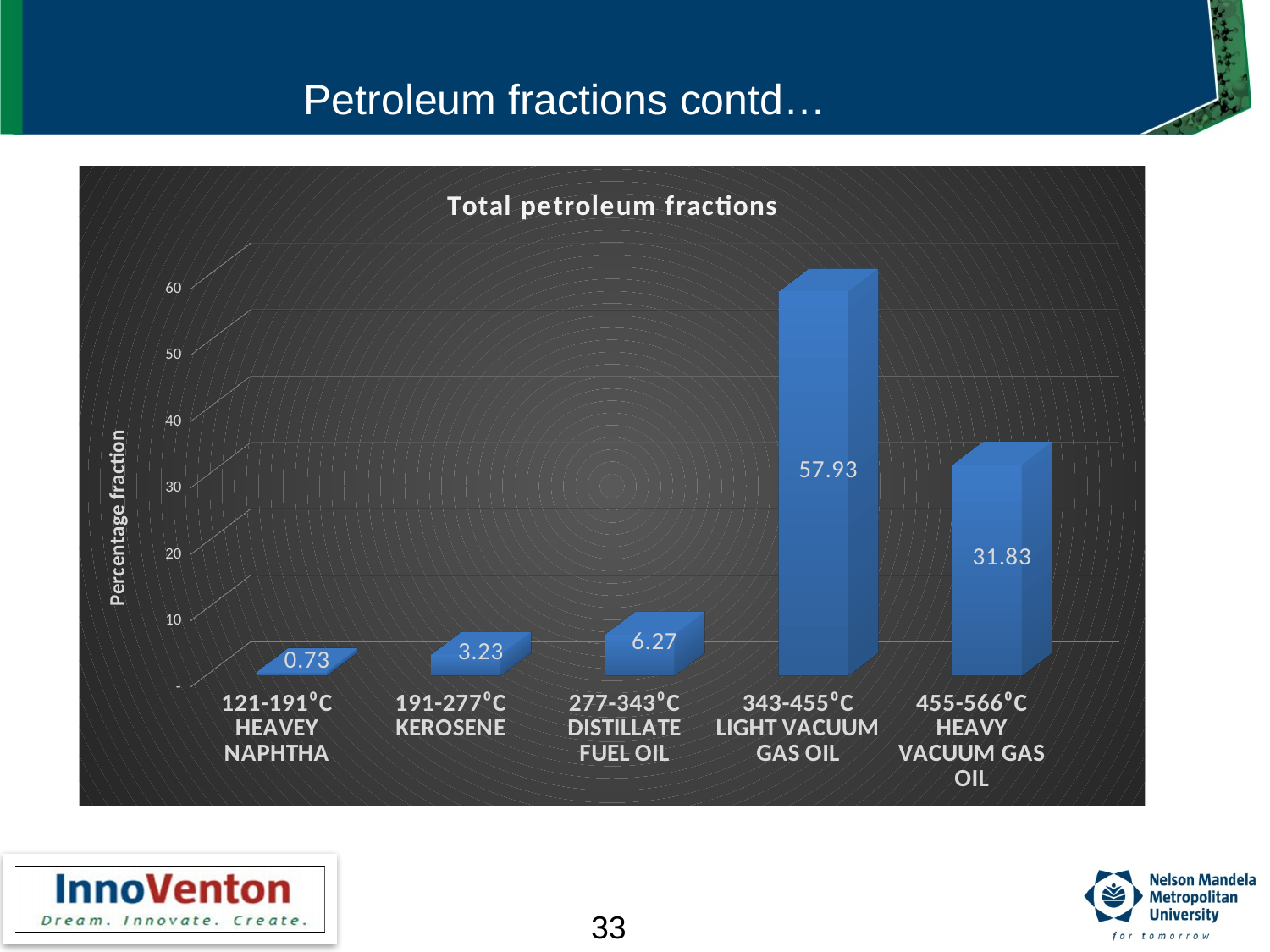
What is the percentage fraction for 191-277°C Kerosene? 3.23 What is the difference between the percentage fractions of Light Vacuum Gas Oil and Heavy Vacuum Gas Oil? 26.1 What is the percentage fraction for 455-566°C Heavy Vacuum Gas Oil? 31.83 What is the percentage fraction for 343-455°C Light Vacuum Gas Oil? 57.93 Which petroleum fraction has the highest percentage? 343-455°C Light Vacuum Gas Oil Which has a larger percentage fraction, Kerosene or Distillate Fuel Oil? Distillate Fuel Oil Is the value for 277-343°C Distillate Fuel Oil greater or less than 10? less How many petroleum fractions are shown on the chart? 5 What type of chart is shown on the slide? Bar chart What is the percentage fraction for 121-191°C Heavey Naphtha? 0.73 What is the title of the chart? Total petroleum fractions Which petroleum fraction has the lowest percentage? 121-191°C Heavey Naphtha